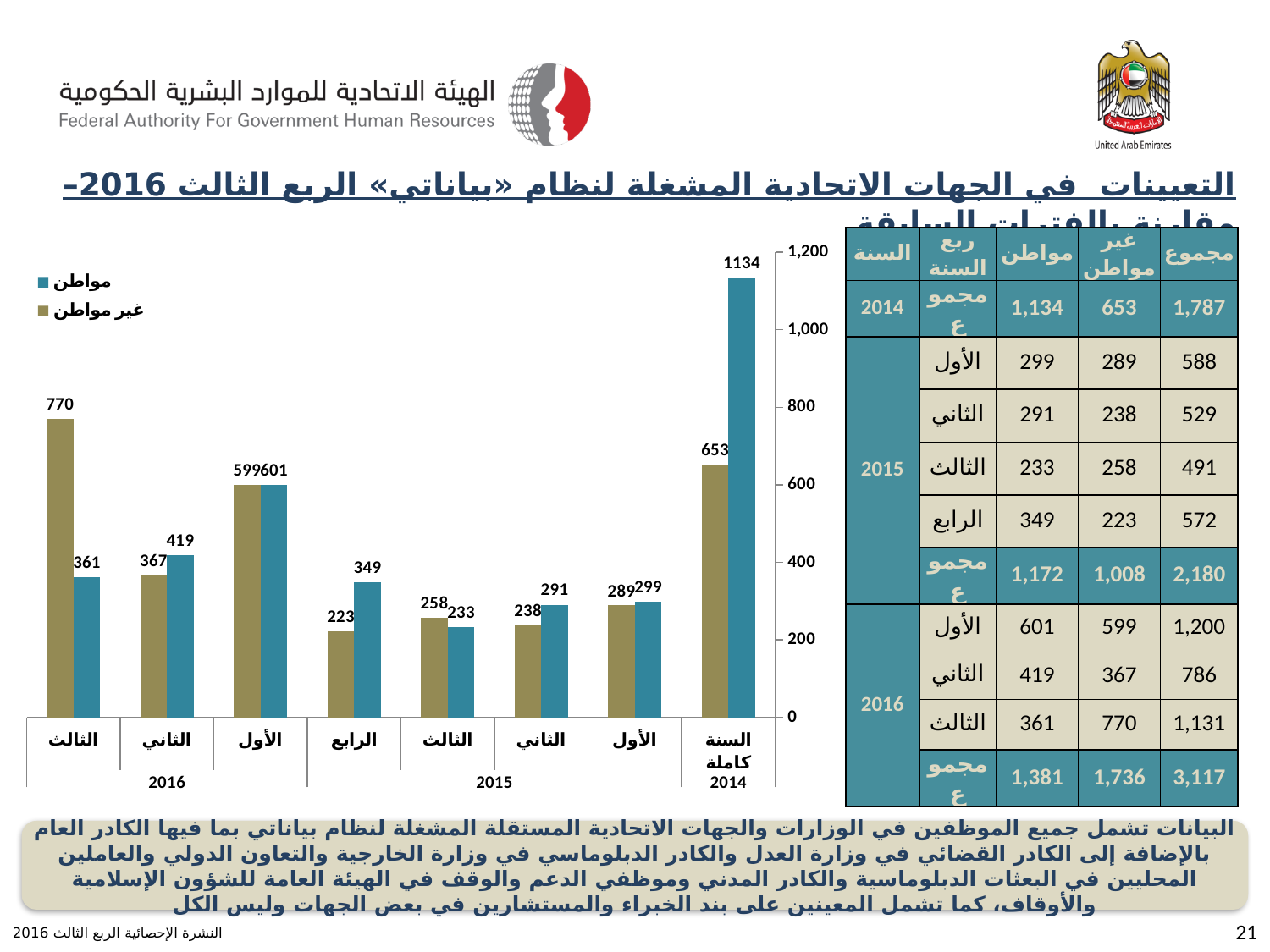
How many categories are shown on the x axis of the chart? 8 Which category has the highest مواطن value in the chart? السنة كاملة 2014 What type of chart is shown on the slide? bar chart What is the value of مواطن for الرابع 2015 in the chart? 349 What is the total of مواطن and غير مواطن for الأول 2016? 1200 Which category has the lowest غير مواطن value in the chart? الرابع 2015 Is the مواطن value for الأول 2016 greater or less than 400? greater What is the value of مواطن for السنة كاملة 2014 in the chart? 1134 What is the difference between the غير مواطن and مواطن values for الثالث 2016? 409 How many series does the chart legend list? 2 For الثاني 2016, which is larger: مواطن or غير مواطن? مواطن What is the value of غير مواطن for الثالث 2016 in the chart? 770